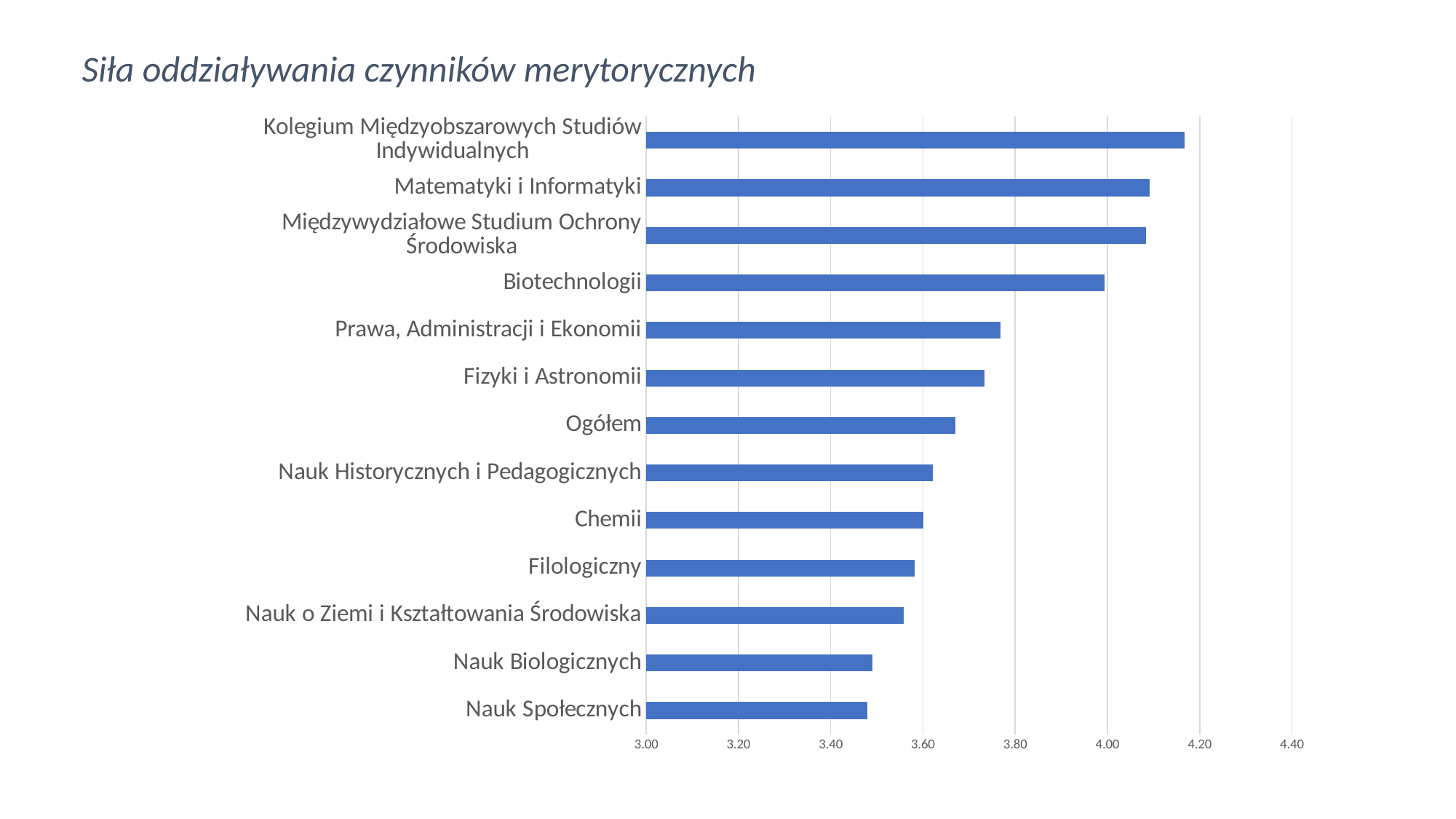
Which category has the highest value? Kolegium Międzyobszarowych Studiów Indywidualnych Is the value for Fizyki i Astronomii greater or less than 3.80? less Is the value for Matematyki i Informatyki greater or less than 4.00? greater What kind of chart is shown on the slide? Bar chart What is the title of the chart? Siła oddziaływania czynników merytorycznych Which has a larger value, Ogółem or Chemii? Ogółem Do the bar values increase or decrease going from the top category to the bottom category? decrease How many categories are plotted in the chart? 13 Is the value for Nauk Biologicznych greater or less than 3.40? greater Which has a larger value, Biotechnologii or Prawa, Administracji i Ekonomii? Biotechnologii